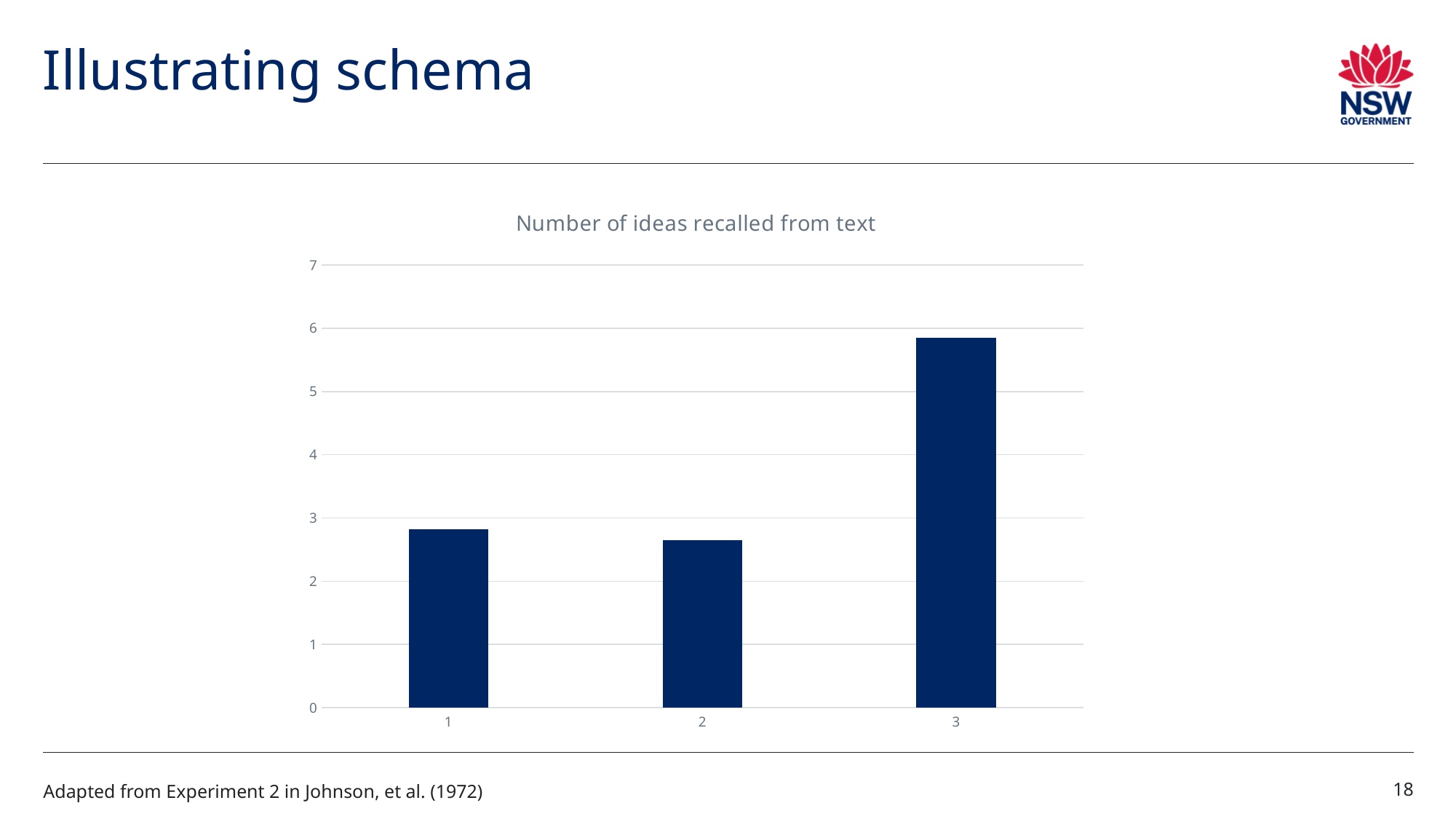
Which is larger, the value for category 1 or the value for category 3? 3 Is the value for category 3 greater or less than 6? less Is the value for category 2 greater or less than 3? less What kind of chart is shown on the slide? bar chart Is the value for category 1 greater or less than 3? less Which category has the highest number of ideas recalled from text? 3 What is the title of the chart? Number of ideas recalled from text Which is larger, the value for category 3 or the value for category 2? 3 What is the highest value shown on the vertical axis? 7 How many bars are plotted in the chart? 3